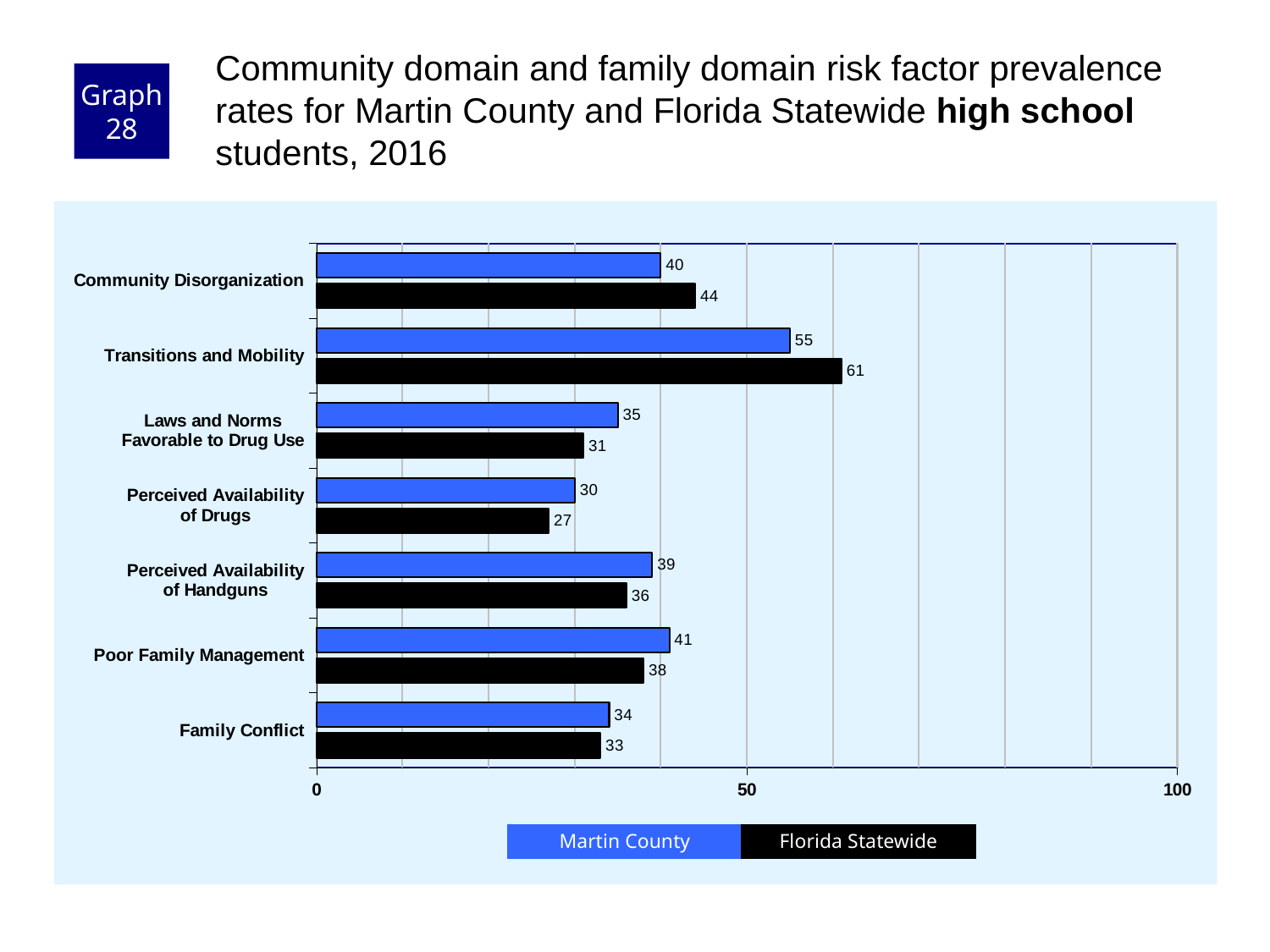
What kind of chart is shown on the slide? bar chart For Poor Family Management, which is larger: the Martin County value or the Florida Statewide value? Martin County What is the difference between the Martin County and Florida Statewide values for Laws and Norms Favorable to Drug Use? 4 What is the difference between the Florida Statewide and Martin County values for Transitions and Mobility? 6 How many series does the legend list? 2 What is the Florida Statewide value for Community Disorganization? 44 Is the Florida Statewide value for Transitions and Mobility greater or less than 50? greater What is the Florida Statewide value for Perceived Availability of Drugs? 27 Which risk factor has the highest Florida Statewide value? Transitions and Mobility What is the Martin County value for Transitions and Mobility? 55 How many risk factor categories are shown on the chart? 7 Which risk factor has the lowest Martin County value? Perceived Availability of Drugs